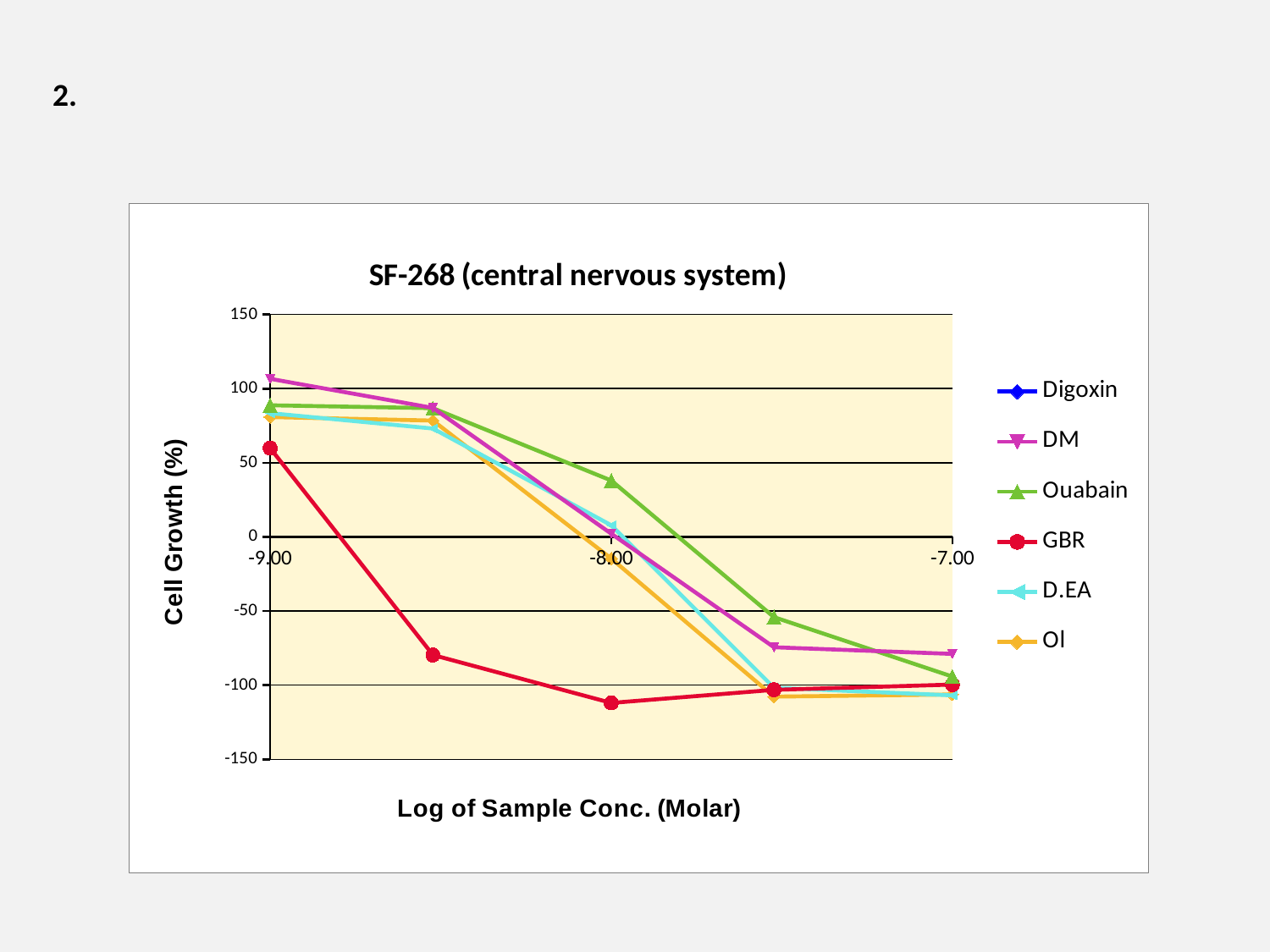
Is the value for GBR at -9.00 greater or less than 50? greater Is the value for Ouabain at -8.00 greater or less than 50? less How many series does the legend list? 6 What is the title of the chart? SF-268 (central nervous system) Is the value for GBR at -8.00 greater or less than -100? less What is the label of the y axis? Cell Growth (%) Which series has the highest value at -8.00? Ouabain What type of chart is shown on the slide? line chart Do the values for Ouabain rise or fall as the log of sample concentration increases from -9.00 to -7.00? fall Which series has the lowest value at -9.00? GBR